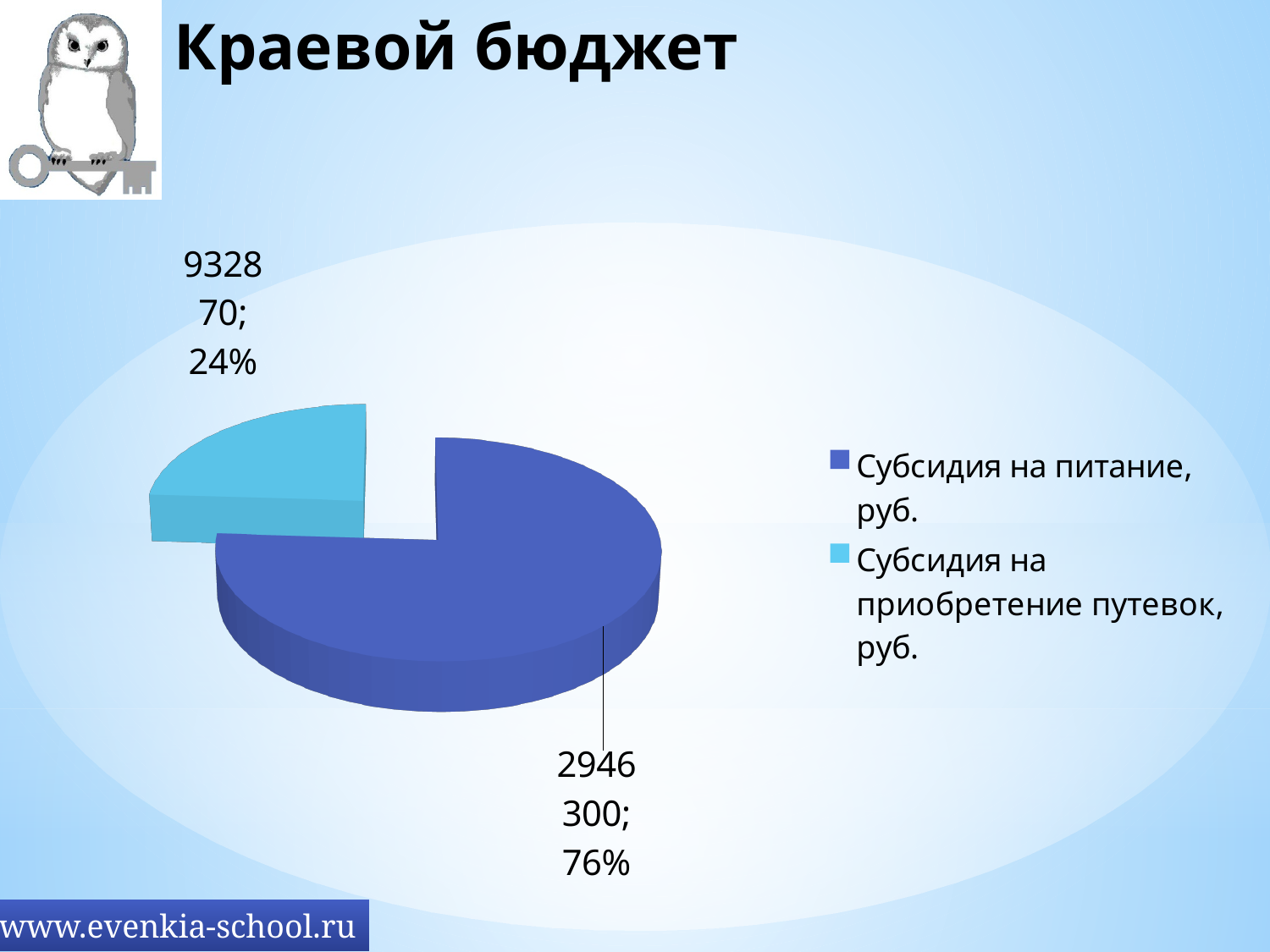
Which category has the largest slice of the pie? Субсидия на питание, руб. How many slices does the pie chart have? 2 What share of the pie does Субсидия на питание, руб. take? 76% Which is larger: Субсидия на питание, руб. or Субсидия на приобретение путевок, руб.? Субсидия на питание, руб. How many entries does the legend list? 2 What is the value for Субсидия на приобретение путевок, руб.? 932870 Which category has the smallest slice of the pie? Субсидия на приобретение путевок, руб. What is the title of the slide containing the chart? Краевой бюджет What share of the pie does Субсидия на приобретение путевок, руб. take? 24% What kind of chart is shown on the slide? pie chart What is the value for Субсидия на питание, руб.? 2946300 What is the difference between the value for Субсидия на питание, руб. and the value for Субсидия на приобретение путевок, руб.? 2013430